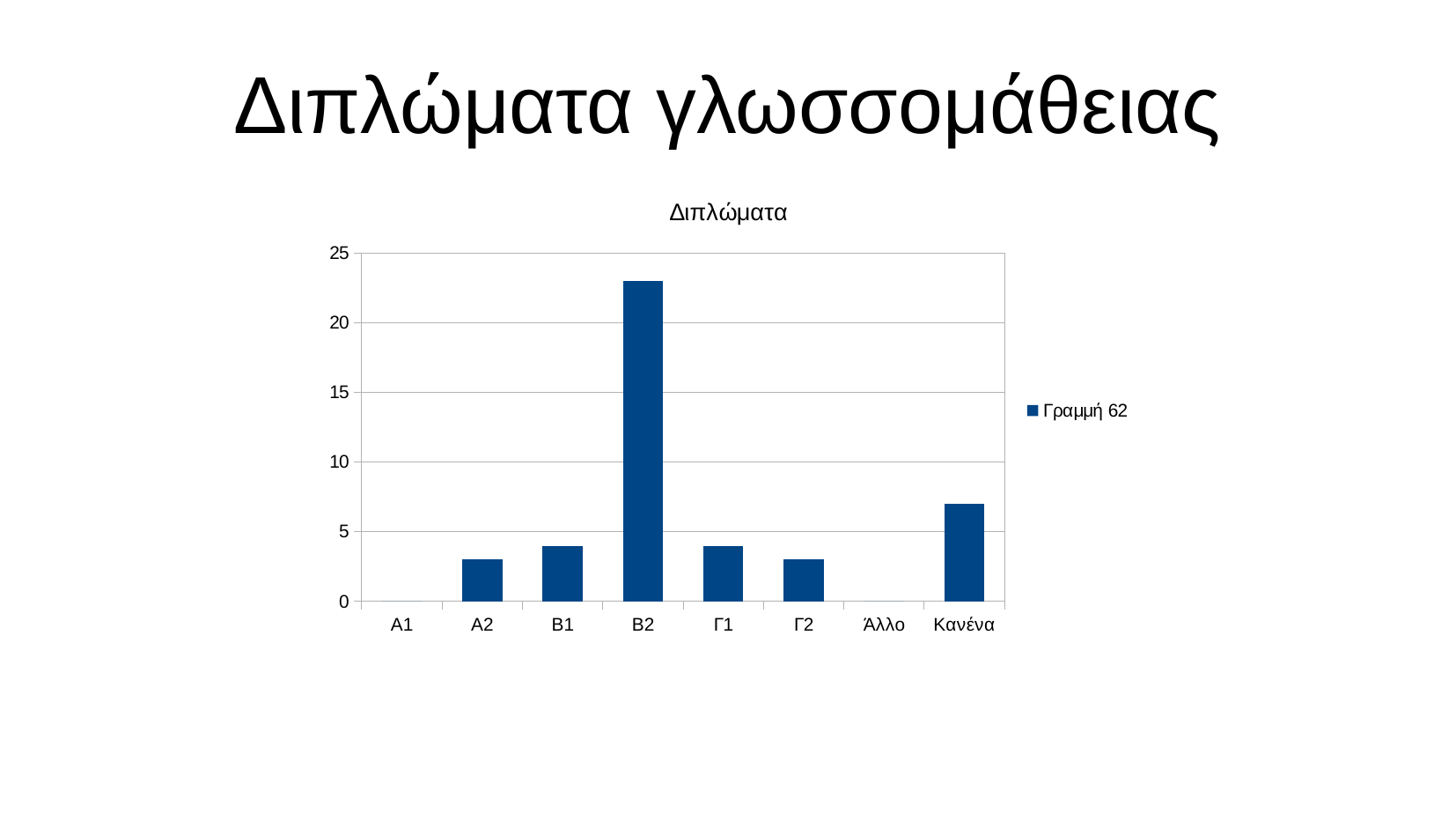
Is the value for B2 greater or less than 20? greater Which is larger, the value for B2 or the value for Κανένα? B2 What kind of chart is shown on the slide? bar chart What is the name of the series shown in the legend? Γραμμή 62 How many categories are shown on the x axis of the chart? 8 How many series does the legend list? 1 Is the value for B1 greater or less than 10? less Which is larger, the value for Κανένα or the value for Γ2? Κανένα What is the title of the chart? Διπλώματα Which category has the highest value? B2 Is the value for Κανένα greater or less than 5? greater